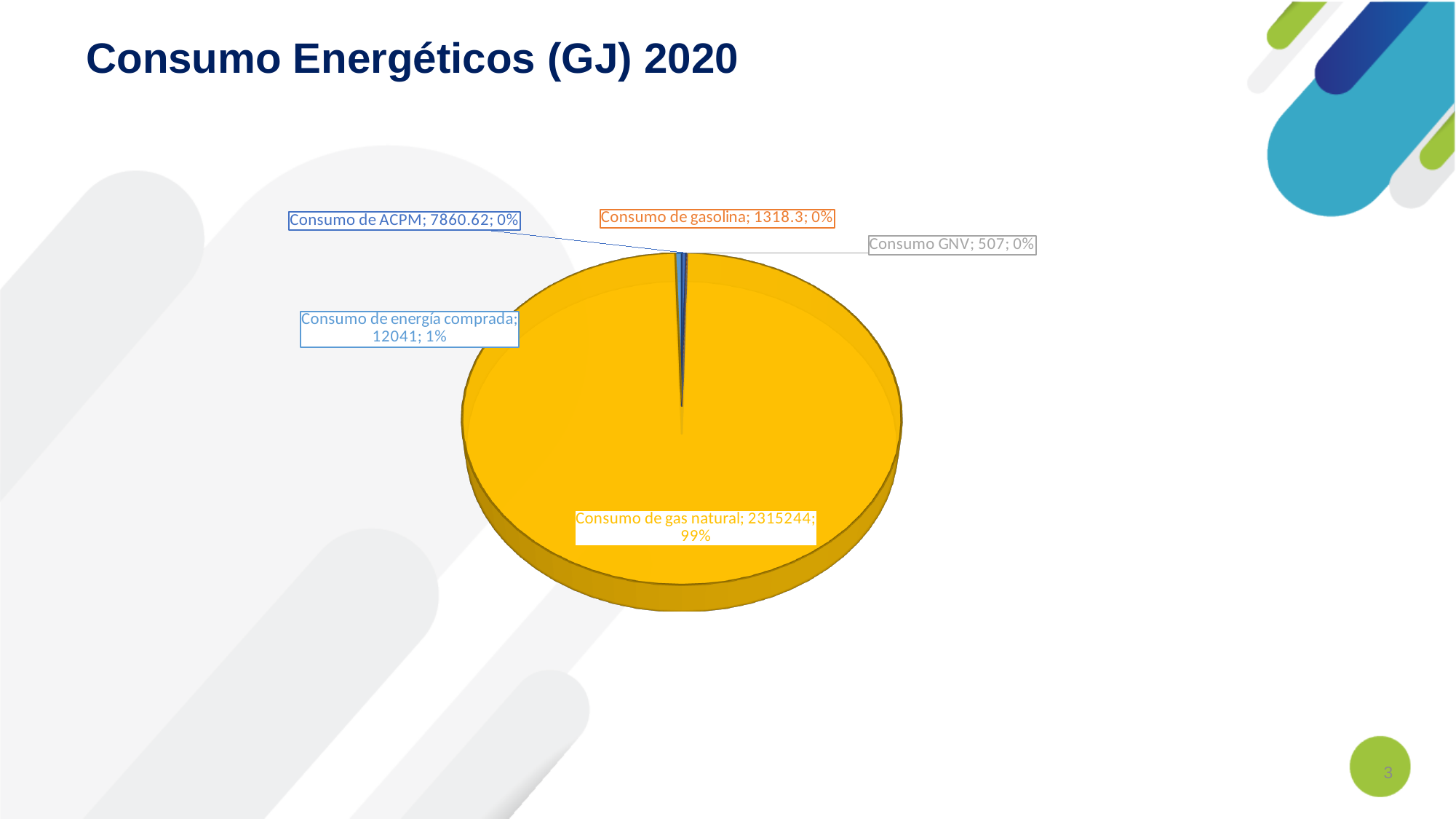
What is the value for Consumo de energía comprada? 12041 What is the value for Consumo GNV? 507 What is the value for Consumo de ACPM? 7860.62 Which category has the largest share of the pie? Consumo de gas natural What is the value for Consumo de gasolina? 1318.3 What is the value for Consumo de gas natural? 2315244 What kind of chart is shown on the slide? Pie chart What share of the pie does Consumo de gas natural represent? 99% Which category has the smallest value? Consumo GNV Which is larger, Consumo de ACPM or Consumo de gasolina? Consumo de ACPM What share of the pie does Consumo de energía comprada represent? 1% How many categories are shown in the pie chart? 5